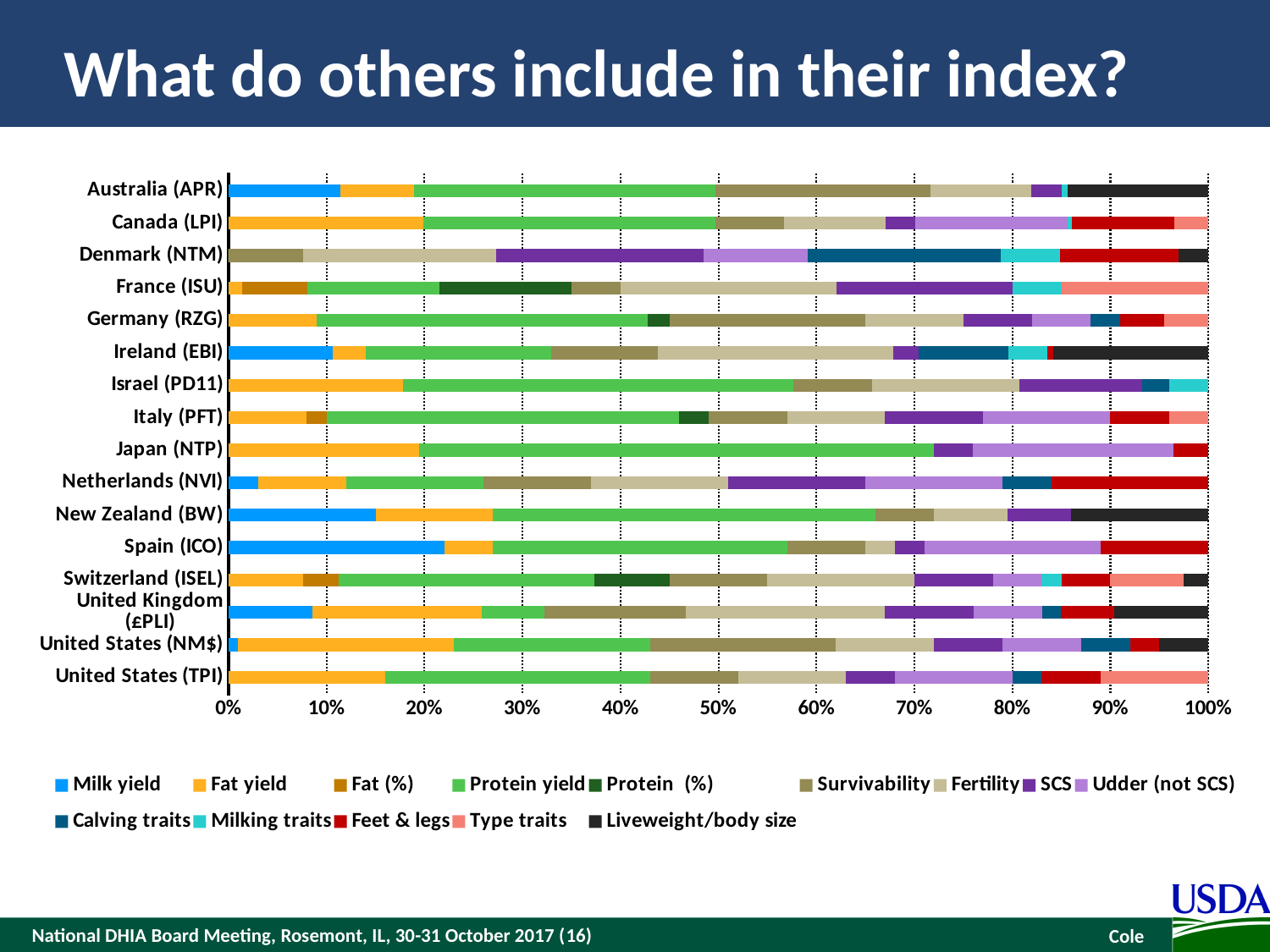
What does each stacked bar total on the x axis? 100% Is the Protein yield segment for Japan (NTP) greater or less than 40%? greater Is the Milk yield segment for Spain (ICO) greater or less than 20%? greater Is the Milk yield segment for Netherlands (NVI) greater or less than 10%? less Which has the larger Milk yield segment, Spain (ICO) or New Zealand (BW)? Spain (ICO) Which index has the largest Protein yield segment? Japan (NTP) How many indices (categories) are plotted on the chart? 16 Which index has the largest Milk yield segment? Spain (ICO) How many series does the legend list? 14 What is the title of the slide containing the chart? What do others include in their index? What kind of chart is shown on the slide? Stacked bar chart